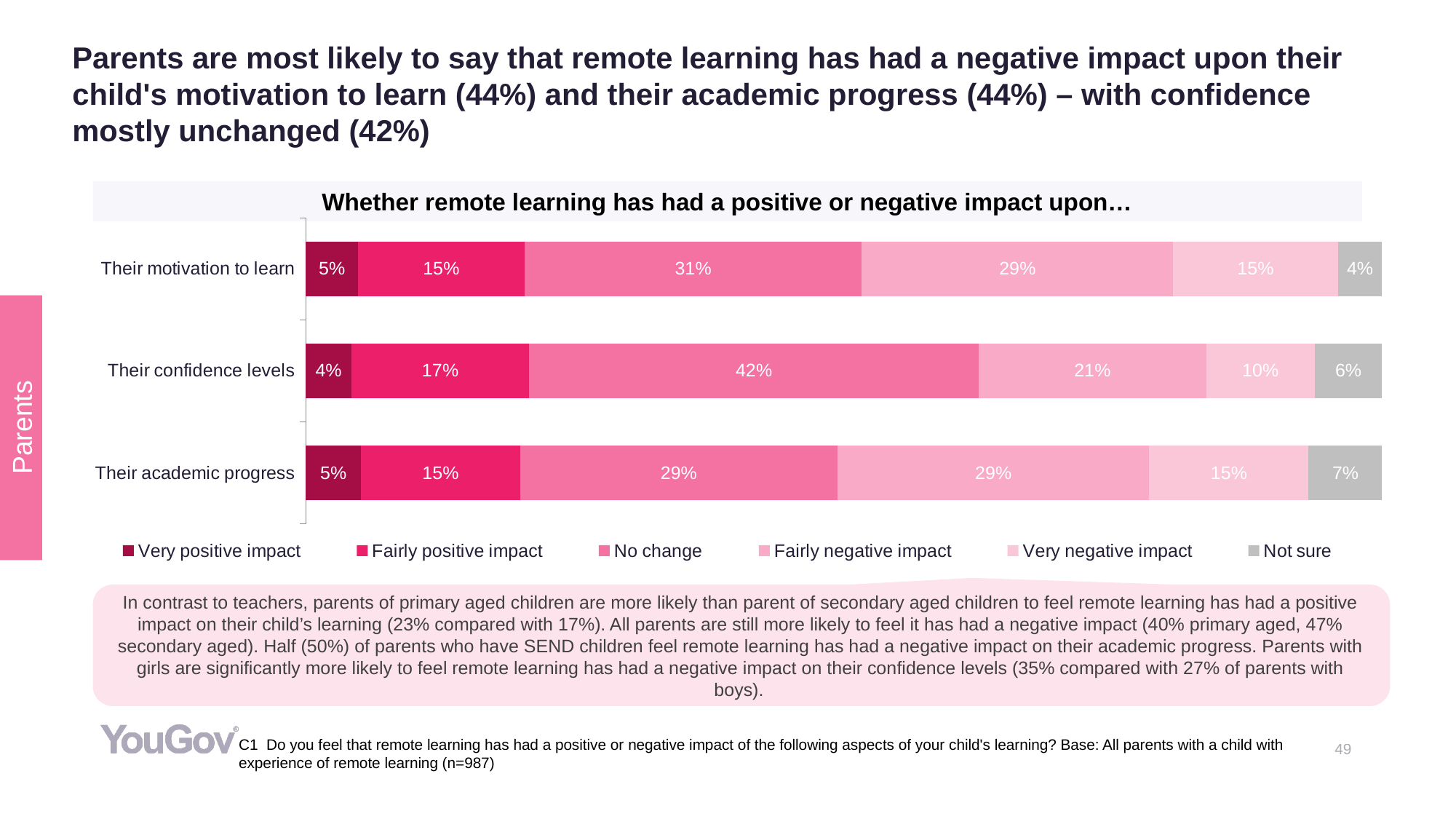
What percentage of parents were 'Not sure' about the impact on their motivation to learn? 4% What is the difference between the 'No change' values for their confidence levels and their academic progress? 13 percentage points What percentage of parents said remote learning had no change on their child's confidence levels? 42% Which category has the lowest 'Fairly negative impact' value? Their confidence levels How many series does the legend list? 6 What kind of chart is shown on the slide? Stacked bar chart What is the title of the chart? Whether remote learning has had a positive or negative impact upon… Which is larger: the 'Not sure' value for their academic progress or for their confidence levels? Their academic progress How many categories are shown on the chart? 3 Which category has the highest 'No change' value? Their confidence levels What is the total of the stacked bar for their confidence levels? 100% What is the value for 'Very negative impact' on their academic progress? 15%